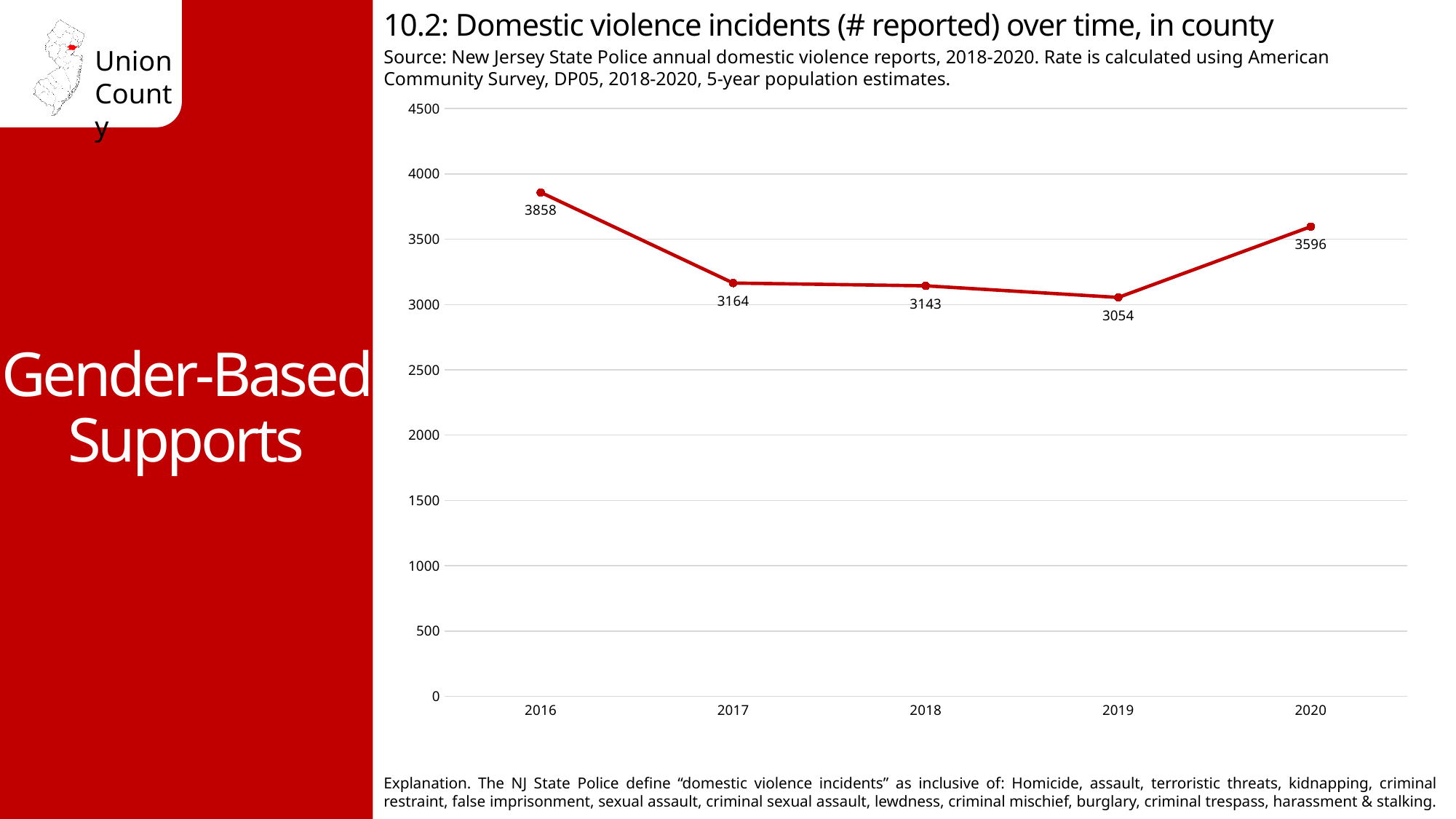
What is the difference in reported incidents between 2020 and 2019? 542 What was the number of reported domestic violence incidents in 2020? 3596 Did the number of reported incidents rise or fall from 2016 to 2019? fall Which year had more reported incidents, 2017 or 2020? 2020 Is the value for 2018 greater or less than 3500? less What was the number of reported domestic violence incidents in 2019? 3054 What kind of chart is shown on the slide? line chart Which year had the lowest number of reported domestic violence incidents? 2019 How many years are plotted on the chart? 5 What is the difference in reported incidents between 2016 and 2017? 694 Which year had the highest number of reported domestic violence incidents? 2016 What was the number of reported domestic violence incidents in 2016? 3858